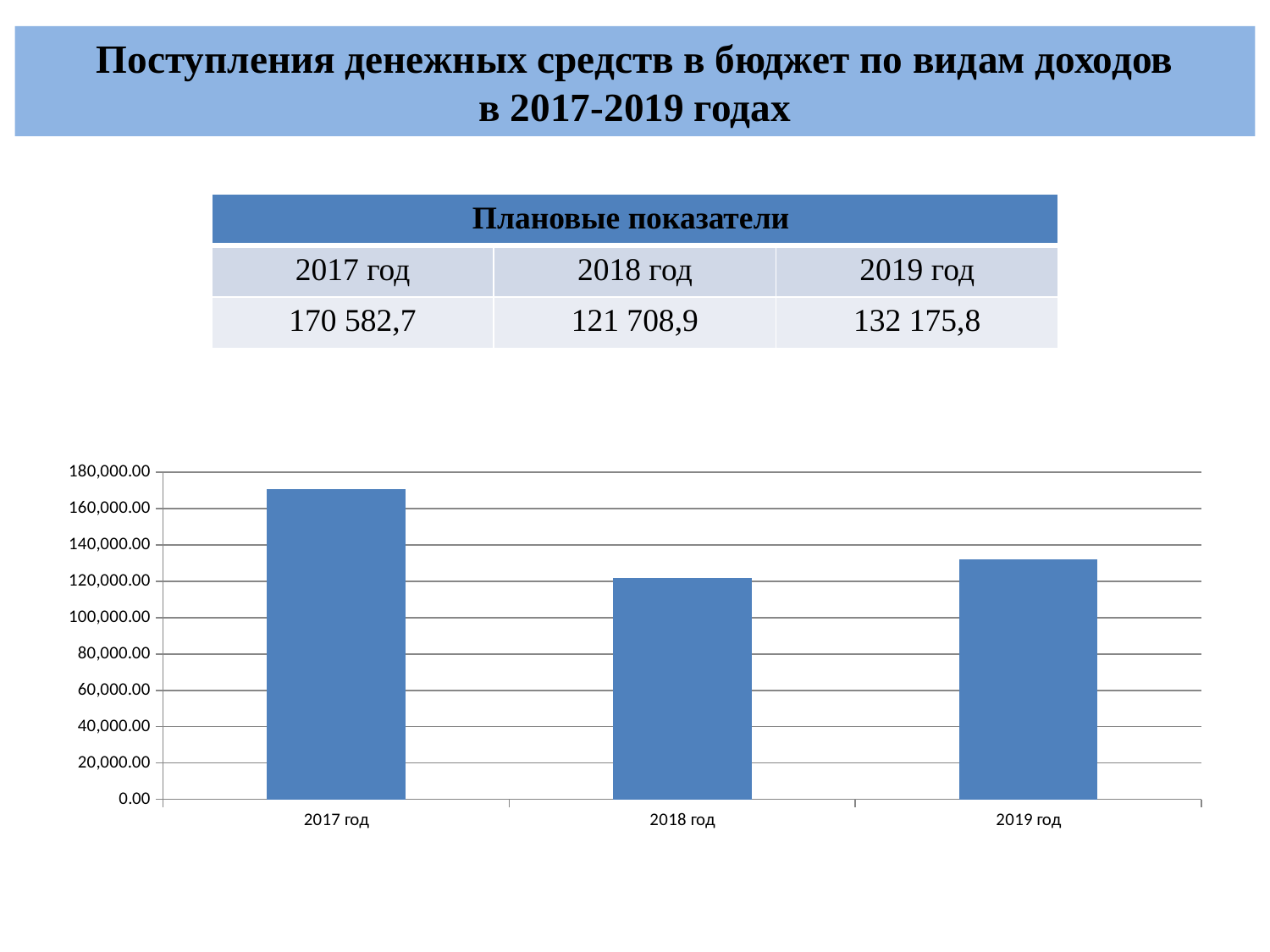
What is the heading of the table above the chart? Плановые показатели Is the value for 2019 год greater or less than 120,000.00? greater What kind of chart is shown on the slide? bar chart Using the table values, what is the difference between 2017 год and 2018 год? 48 873,8 Is the value for 2018 год greater or less than 140,000.00? less How many bars (categories) does the chart show? 3 Is the value for 2017 год greater or less than 160,000.00? greater According to the table of planned indicators, what is the value for 2017 год? 170 582,7 According to the table of planned indicators, what is the value for 2019 год? 132 175,8 Which year has the highest bar in the chart? 2017 год Which year has the lowest bar in the chart? 2018 год Which is larger, the value for 2019 год or the value for 2018 год? 2019 год